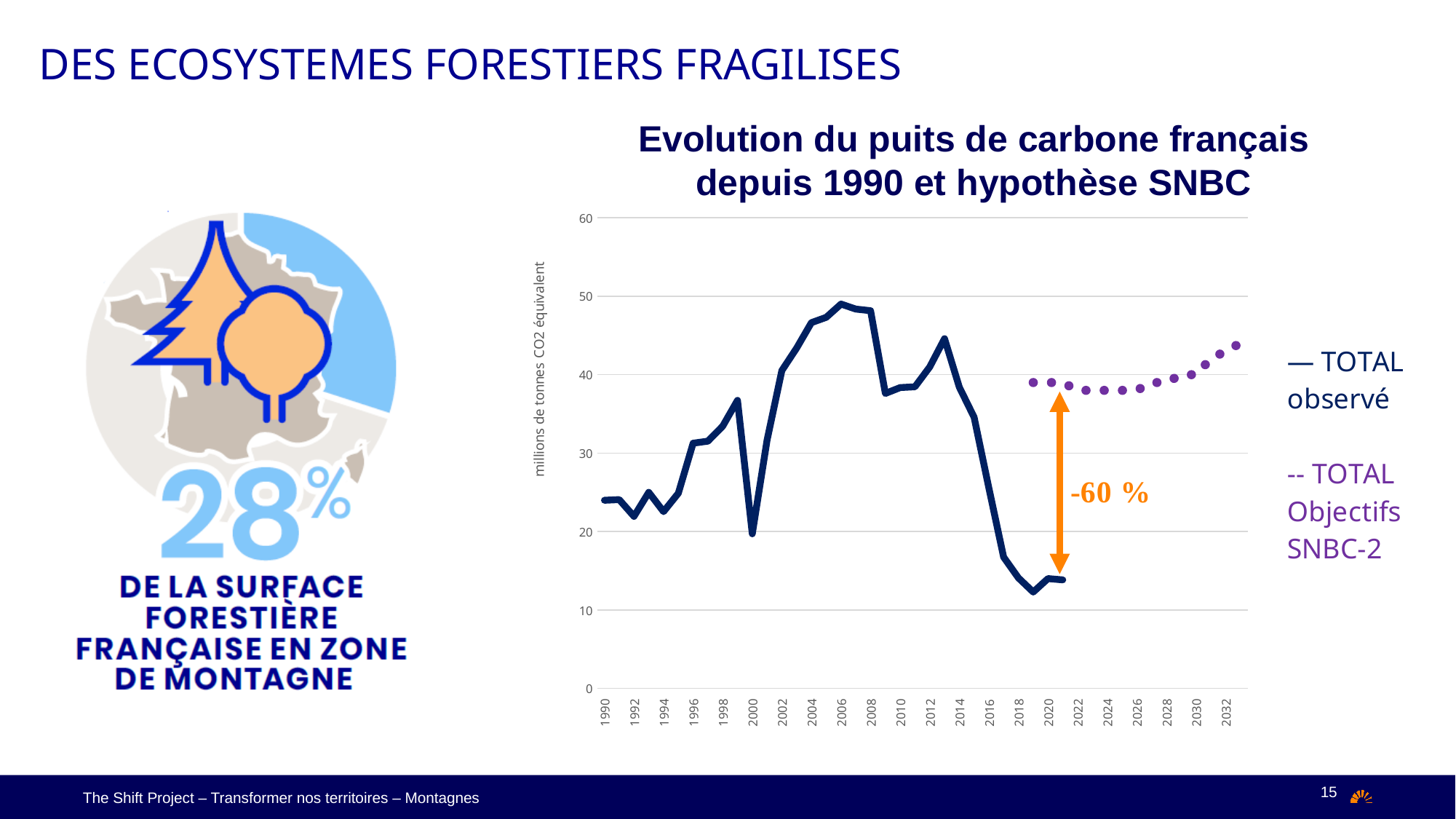
Which is larger for TOTAL observé: the value in 2006 or the value in 2019? 2006 Is the value of TOTAL Objectifs SNBC-2 in 2032 greater or less than 40? greater Does the TOTAL observé series rise or fall between 2013 and 2019? fall How many series does the legend of the carbon sink chart list? 2 Is the value of TOTAL observé in 1990 greater or less than 20? greater Is the value of TOTAL observé in 2006 greater or less than 40? greater What are the two series named in the legend of the carbon sink chart? TOTAL observé and TOTAL Objectifs SNBC-2 What is the y-axis label of the carbon sink chart? millions de tonnes CO2 équivalent What kind of chart is shown under the title 'Evolution du puits de carbone français depuis 1990 et hypothèse SNBC'? line chart What percentage change is indicated by the orange arrow annotation on the carbon sink chart? -60 %